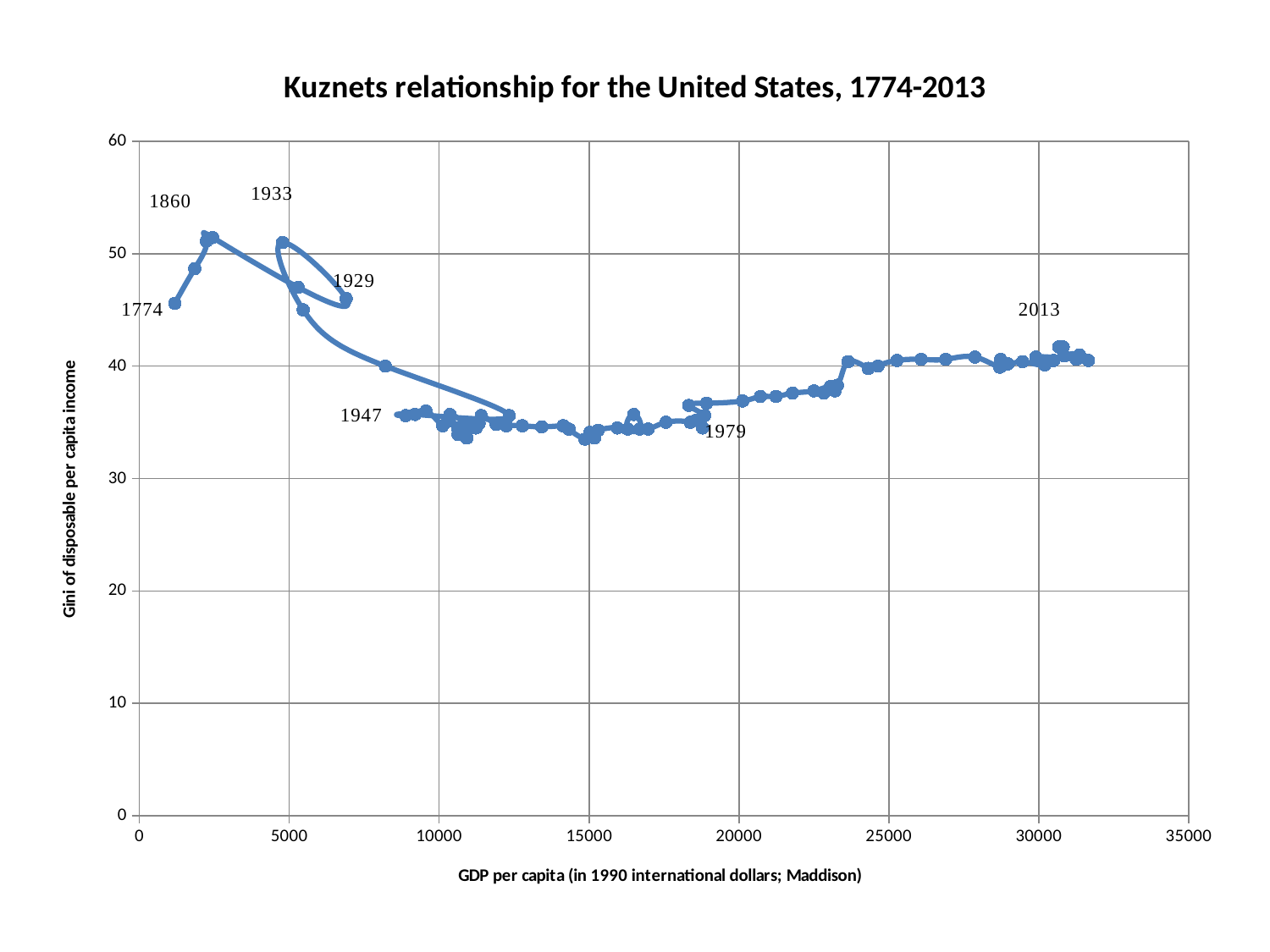
Is the Gini value for the point labelled 1860 greater or less than 50? greater What is the title of the chart? Kuznets relationship for the United States, 1774-2013 How many points on the chart are annotated with a year label? 7 Is the GDP per capita for the point labelled 1979 greater or less than 20000? less What is the label of the vertical axis? Gini of disposable per capita income Which has the higher Gini value, the point labelled 2013 or the point labelled 1979? 2013 Which has the higher Gini value, the point labelled 1933 or the point labelled 1929? 1933 Is the Gini value for the point labelled 1947 greater or less than 40? less What kind of chart is shown on the slide? scatter chart